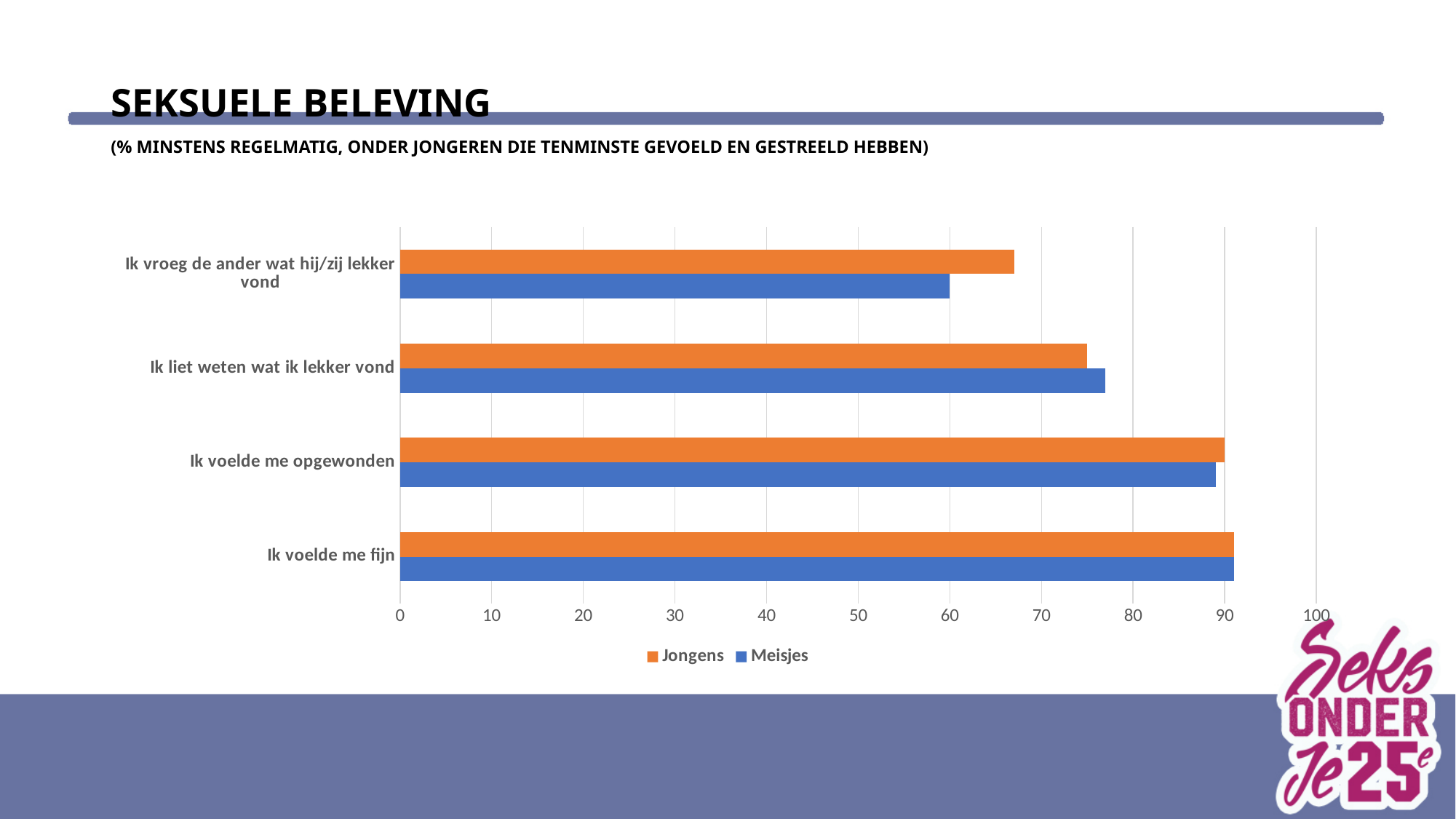
Is the Meisjes value for 'Ik liet weten wat ik lekker vond' greater or less than 80? less Which category has the lowest Meisjes value? Ik vroeg de ander wat hij/zij lekker vond Which category has the lowest Jongens value? Ik vroeg de ander wat hij/zij lekker vond How many series does the legend list? 2 Is the Jongens value for 'Ik vroeg de ander wat hij/zij lekker vond' greater or less than 60? greater How many categories are shown on the chart? 4 Is the Meisjes value for 'Ik vroeg de ander wat hij/zij lekker vond' greater or less than 70? less What kind of chart is shown on the slide? bar chart For 'Ik vroeg de ander wat hij/zij lekker vond', which is larger: Jongens or Meisjes? Jongens What are the two series named in the legend? Jongens and Meisjes Which colour represents Jongens in the chart? orange